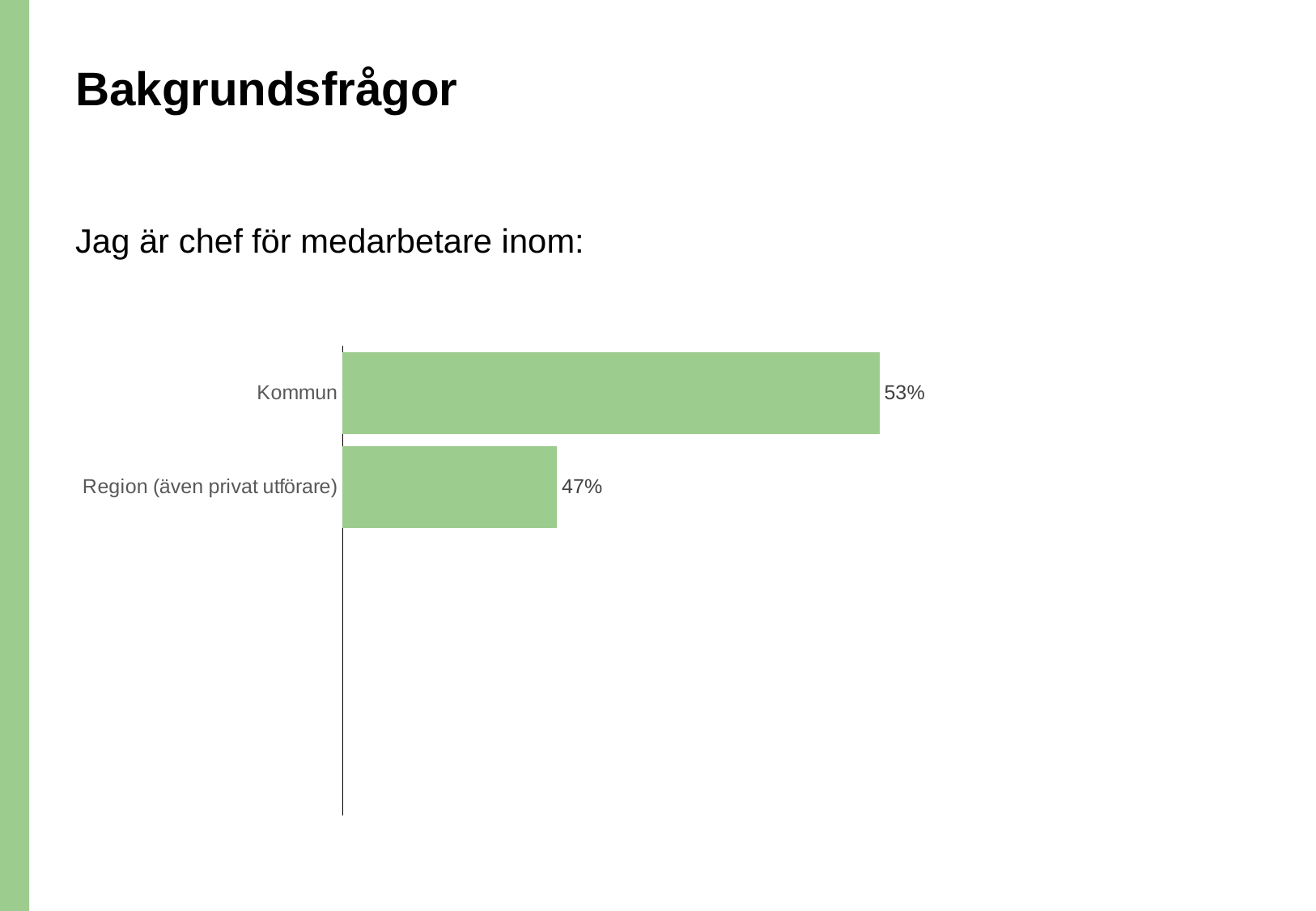
What is the total of the two values shown in the chart? 100% What is the value for Kommun? 53% What is the difference between the values for Kommun and Region (även privat utförare)? 6% What is the value for Region (även privat utförare)? 47% How many categories are shown in the chart? 2 What question does the chart answer, as stated above it? Jag är chef för medarbetare inom: What colour are the bars in the chart? Green Which category has the lowest value? Region (även privat utförare) What kind of chart is shown on the slide? Bar chart Which is larger, the value for Kommun or the value for Region (även privat utförare)? Kommun Which category has the highest value? Kommun